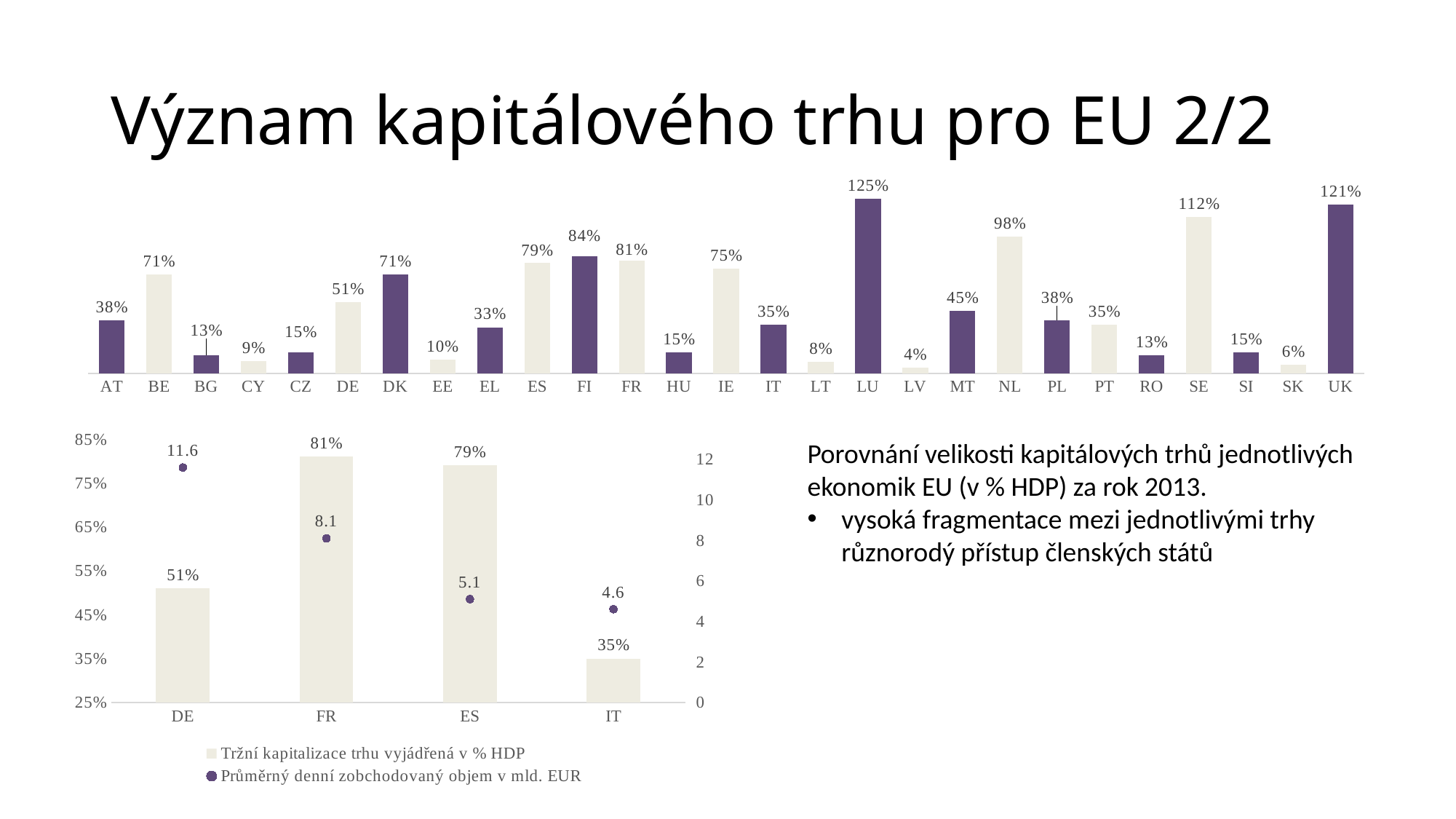
In the bottom chart, which country has the lowest Průměrný denní zobchodovaný objem v mld. EUR? IT In the top chart, which country has the highest value? LU What kind of chart is the top chart? bar chart In the top chart, which is larger, the value for NL or the value for IE? NL In the top chart, what is the difference between the values for UK and SE? 9% How many series does the legend of the bottom chart list? 2 In the bottom chart, what is the difference between the Průměrný denní zobchodovaný objem for FR and ES? 3 In the top chart, how many countries are shown? 27 In the bottom chart, what is the Tržní kapitalizace trhu vyjádřená v % HDP for IT? 35% In the top chart, what is the value for LU? 125% In the top chart, which country has the lowest value? LV In the bottom chart, what is the Průměrný denní zobchodovaný objem v mld. EUR for DE? 11.6